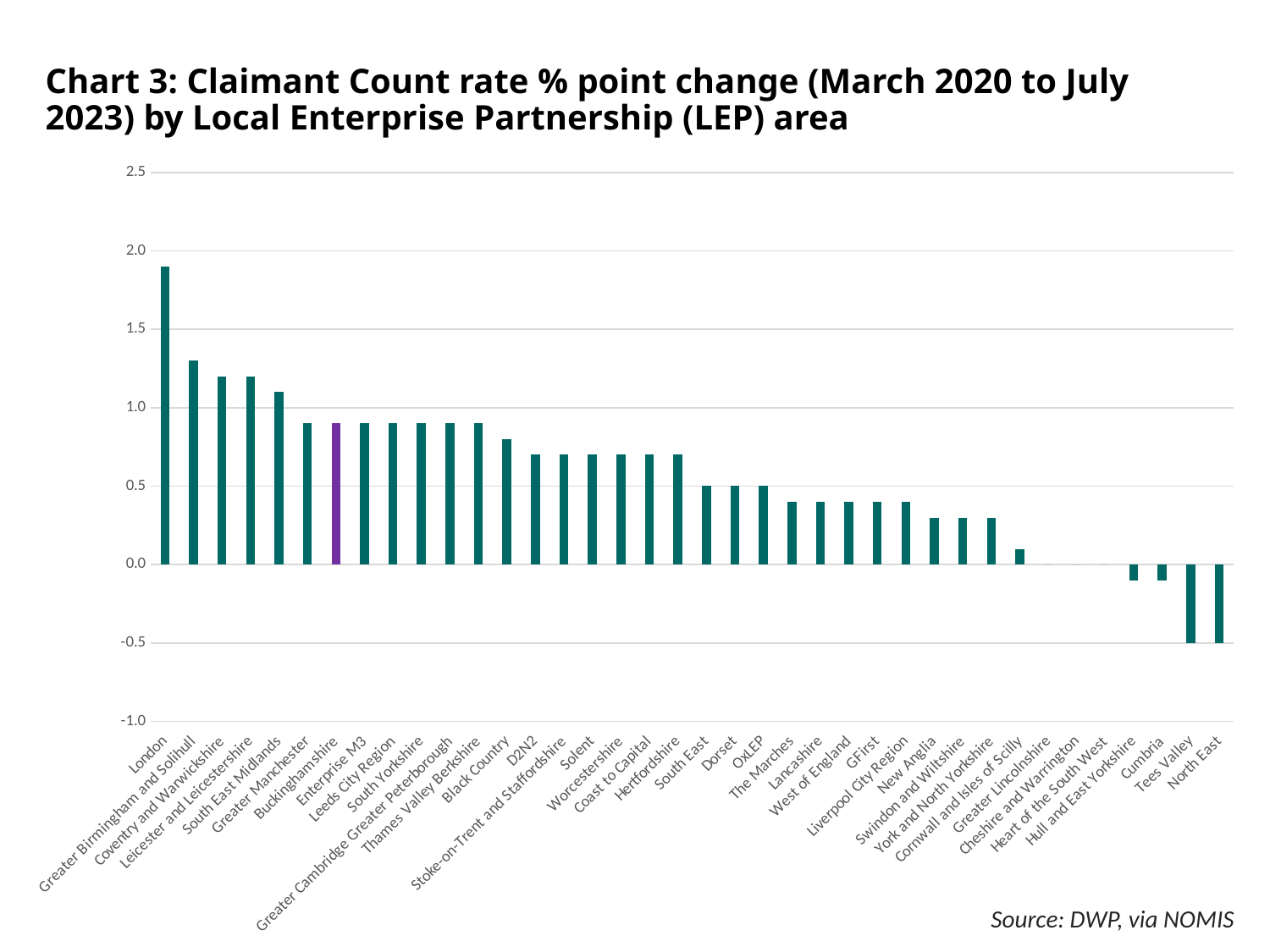
Which LEP area has the highest Claimant Count rate % point change? London Which has the larger value, London or Greater Manchester? London What kind of chart is shown on the slide? bar chart Is the value for Cornwall and Isles of Scilly greater or less than 0.5? less How many LEP areas are listed along the x axis? 38 Is the value for Hertfordshire greater or less than 0.5? greater Is the value for Cumbria greater or less than 0.0? less Which has the larger value, Black Country or South East? Black Country Which LEP area's bar is coloured purple rather than green? Buckinghamshire Do the values generally rise or fall moving from left to right along the x axis? fall